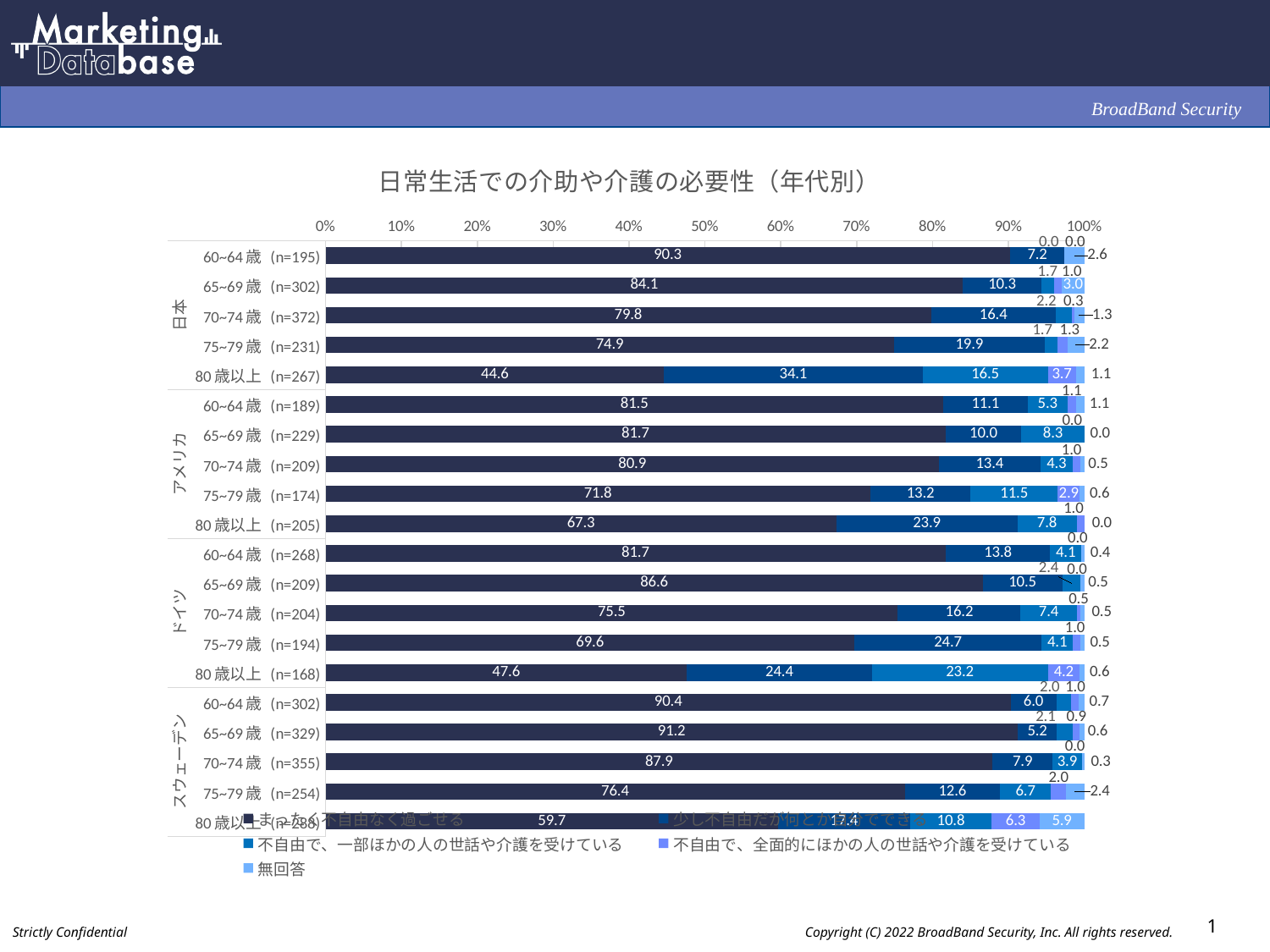
What is the value of the まったく不自由なく過ごせる segment for スウェーデン 65~69歳 (n=329)? 91.2 How many bars (country and age-group combinations) are plotted in the chart? 20 Within 日本, does the まったく不自由なく過ごせる value rise or fall as the age group gets older? Fall Among the 日本 age groups, which has the highest value for まったく不自由なく過ごせる? 60~64歳 For ドイツ 80歳以上 (n=168), what is the value of the 少し不自由だが何とか自分でできる segment? 24.4 What percentage of Japanese respondents aged 60~64 (n=195) answered まったく不自由なく過ごせる? 90.3 Among the 日本 age groups, which has the lowest value for まったく不自由なく過ごせる? 80歳以上 For 日本 80歳以上 (n=267), what is the difference between the まったく不自由なく過ごせる value (44.6) and the 少し不自由だが何とか自分でできる value (34.1)? 10.5 How many series does the legend list? 5 Is the まったく不自由なく過ごせる value for アメリカ 80歳以上 (n=205) greater or less than 60%? greater Which has a larger まったく不自由なく過ごせる value: ドイツ 60~64歳 or ドイツ 65~69歳? ドイツ 65~69歳 What type of chart is shown on the slide? Stacked bar chart